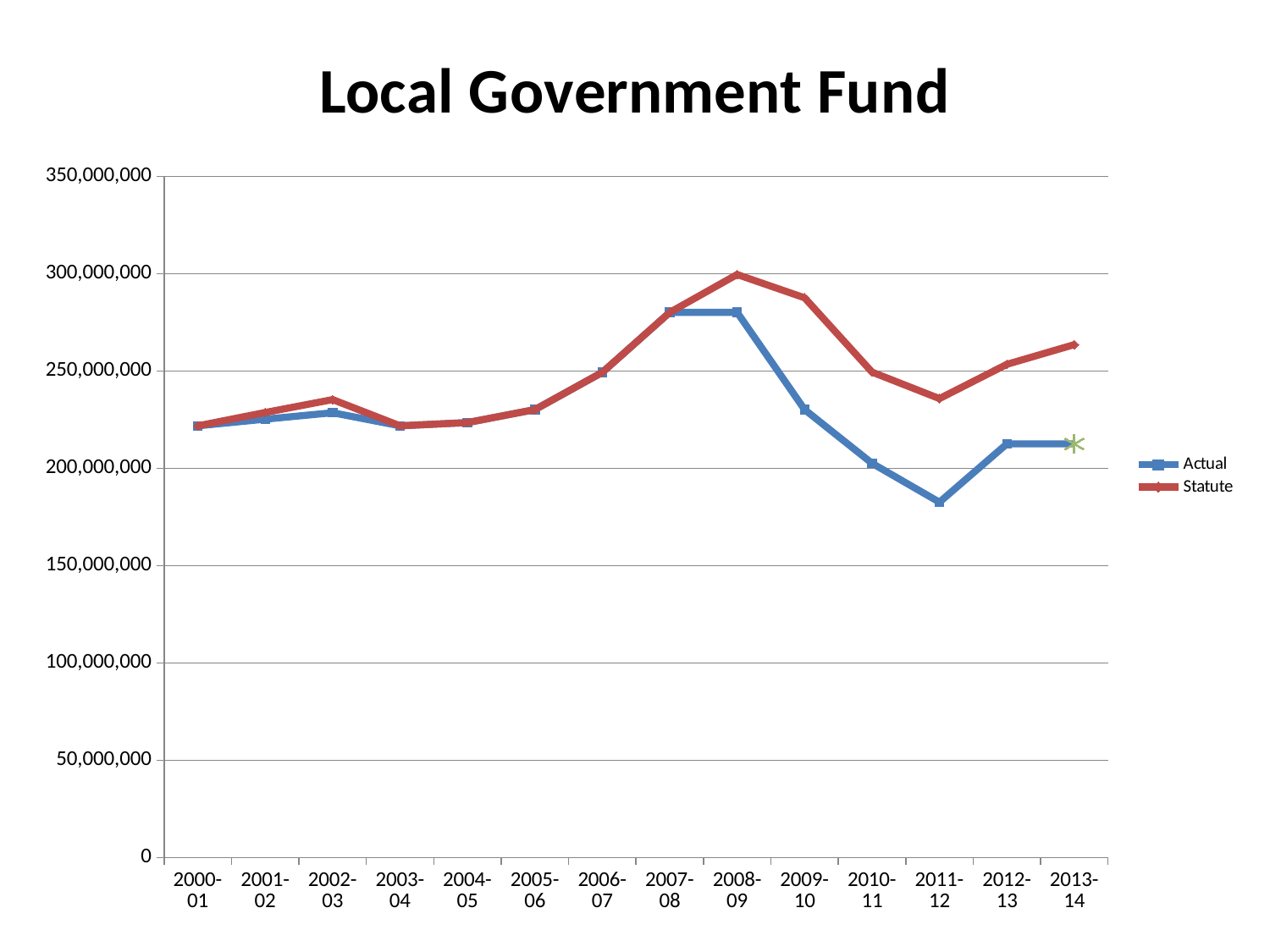
Does the Statute series rise or fall from 2003-04 to 2008-09? Rise What kind of chart is shown on the slide? Line chart How many fiscal years are shown along the x axis? 14 Is the Statute value for 2011-12 greater or less than 250,000,000? less In 2009-10, which series has the larger value, Actual or Statute? Statute How many series does the legend list? 2 In which fiscal year does the Statute series reach its highest value? 2008-09 Does the Actual series rise or fall from 2008-09 to 2011-12? Fall What is the title of the chart? Local Government Fund In which fiscal year does the Actual series reach its lowest value? 2011-12 Is the Actual value for 2011-12 greater or less than 200,000,000? less Is the Statute value for 2009-10 greater or less than 250,000,000? greater